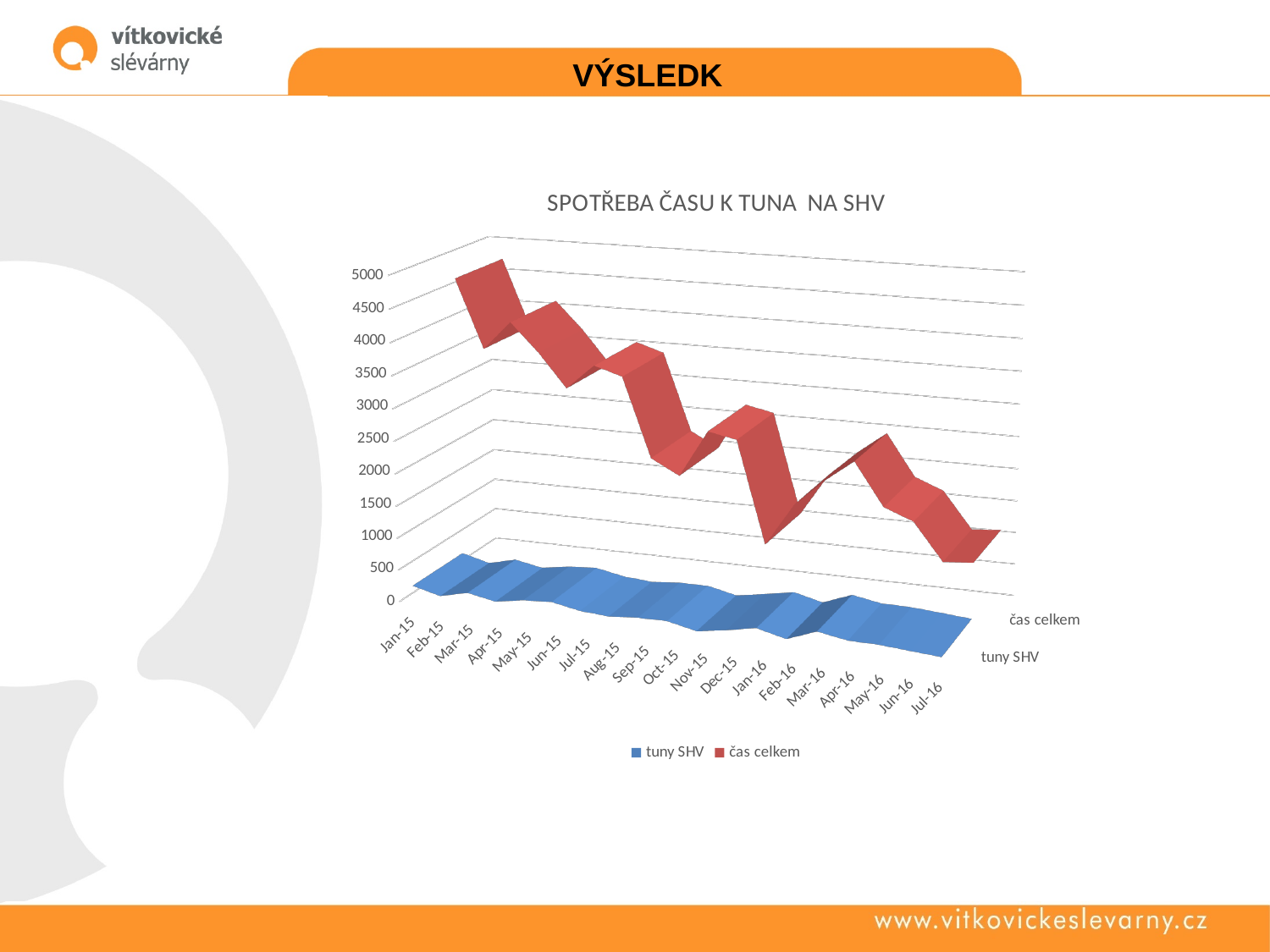
What is the last month shown on the x axis? Jul-16 What is the title of the chart? SPOTŘEBA ČASU K TUNA NA SHV In which month is the čas celkem series highest? Jan-15 Is the value of čas celkem in Jan-15 greater or less than 2000? greater Is the value of tuny SHV in Jan-15 greater or less than 1000? less Which series has the larger value in Jan-15, tuny SHV or čas celkem? čas celkem How many months are shown on the x axis? 19 Does the čas celkem series generally rise or fall from Jan-15 to Jul-16? fall What is the first month shown on the x axis? Jan-15 What kind of chart is shown on the slide? 3D line chart What are the names of the two series in the legend? tuny SHV and čas celkem How many series does the legend list? 2